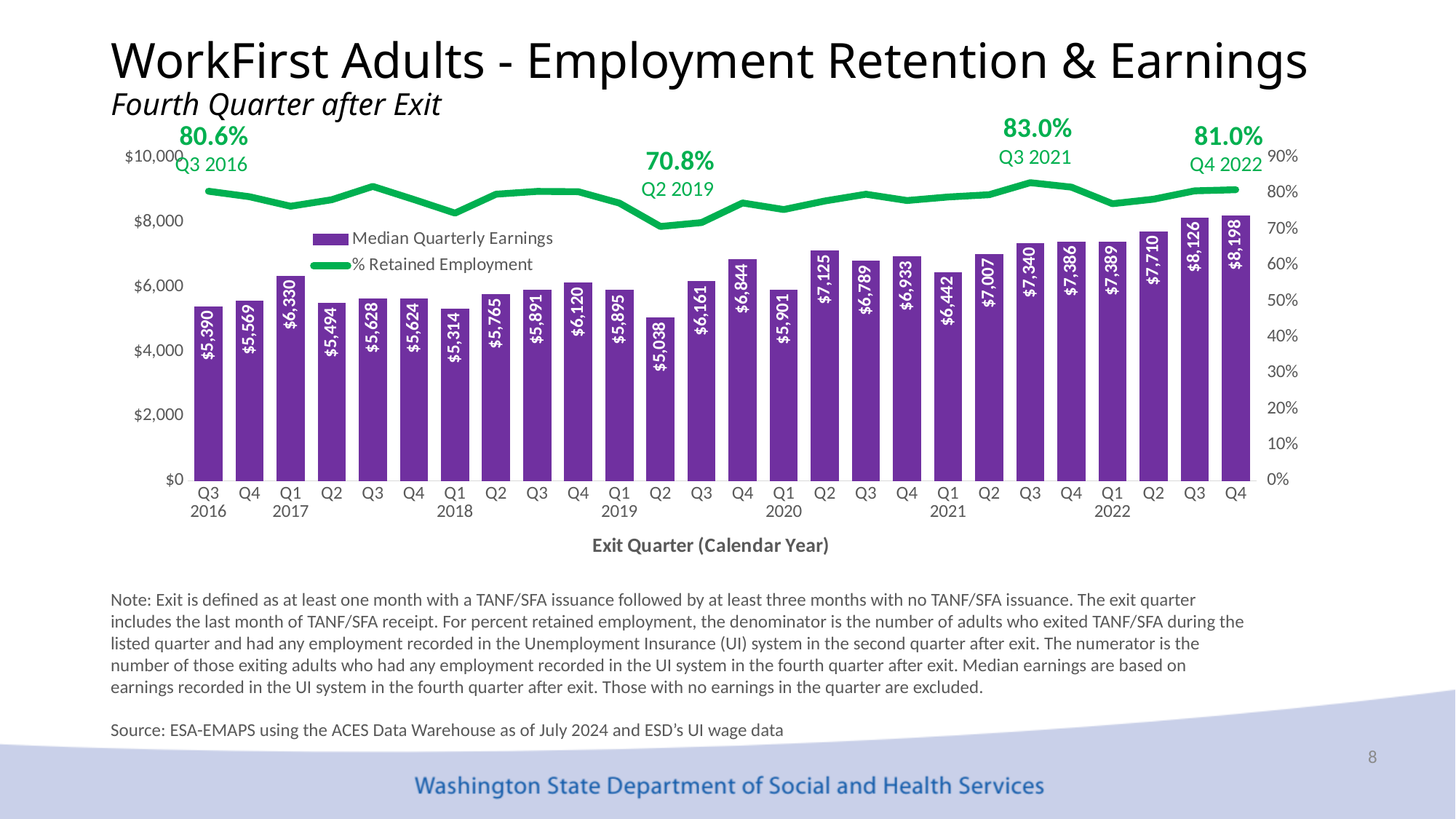
What is the median quarterly earnings value for Q2 2019? $5,038 How many series does the legend list? 2 What percent retained employment is labeled for Q3 2021? 83.0% Which exit quarter has the highest median quarterly earnings? Q4 2022 Which has higher median quarterly earnings, Q4 2019 or Q1 2020? Q4 2019 How many exit quarters are shown on the x axis? 26 Which exit quarter has the lowest median quarterly earnings? Q2 2019 Is the % retained employment for Q2 2019 greater or less than 80%? less What is the median quarterly earnings value for Q4 2022? $8,198 What kind of chart is shown on the slide? Combined bar and line chart What is the difference in median quarterly earnings between Q1 2017 and Q2 2017? $836 What percent retained employment is labeled for Q2 2019? 70.8%